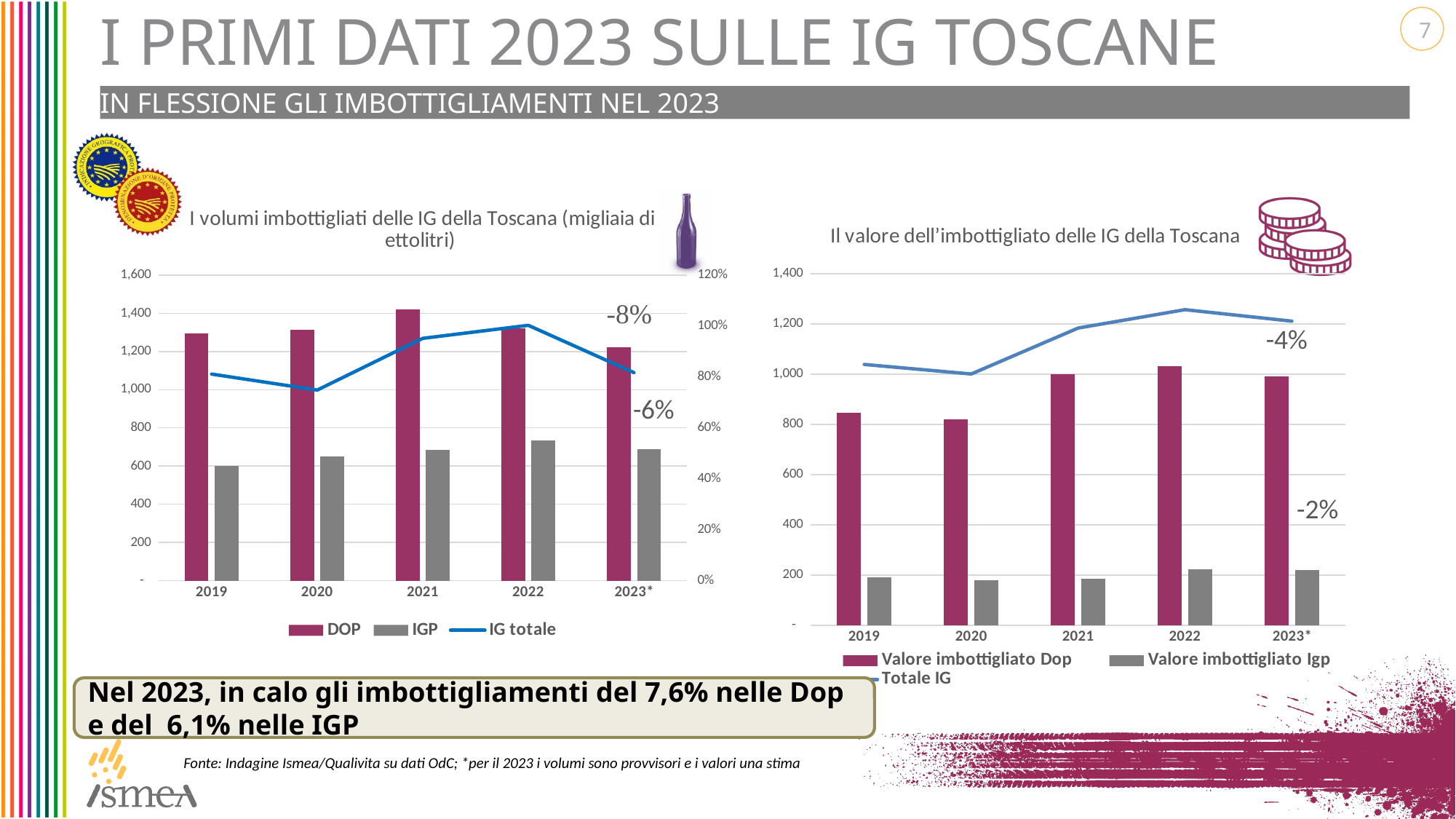
In the right chart 'Il valore dell'imbottigliato delle IG della Toscana', does the Totale IG line rise or fall from 2020 to 2022? rise In the right chart 'Il valore dell'imbottigliato delle IG della Toscana', is the Valore imbottigliato Igp for 2019 greater or less than 400? less In the left chart 'I volumi imbottigliati delle IG della Toscana', what percentage change is annotated next to the 2023* DOP bar? -8% In the right chart 'Il valore dell'imbottigliato delle IG della Toscana', which is larger in 2019: Valore imbottigliato Dop or Valore imbottigliato Igp? Valore imbottigliato Dop In the left chart 'I volumi imbottigliati delle IG della Toscana', how many years are shown on the x axis? 5 In the left chart 'I volumi imbottigliati delle IG della Toscana', which year has the lowest IGP bar? 2019 In the left chart 'I volumi imbottigliati delle IG della Toscana', does the IG totale line rise or fall from 2022 to 2023*? fall In the left chart 'I volumi imbottigliati delle IG della Toscana', is the DOP value for 2019 greater or less than 1,200? greater What kind of chart is the left chart, 'I volumi imbottigliati delle IG della Toscana'? bar chart with a line How many series does the legend of the left chart 'I volumi imbottigliati delle IG della Toscana' list? 3 How many series does the legend of the right chart 'Il valore dell'imbottigliato delle IG della Toscana' list? 3 In the left chart 'I volumi imbottigliati delle IG della Toscana', which year has the highest DOP bar? 2021